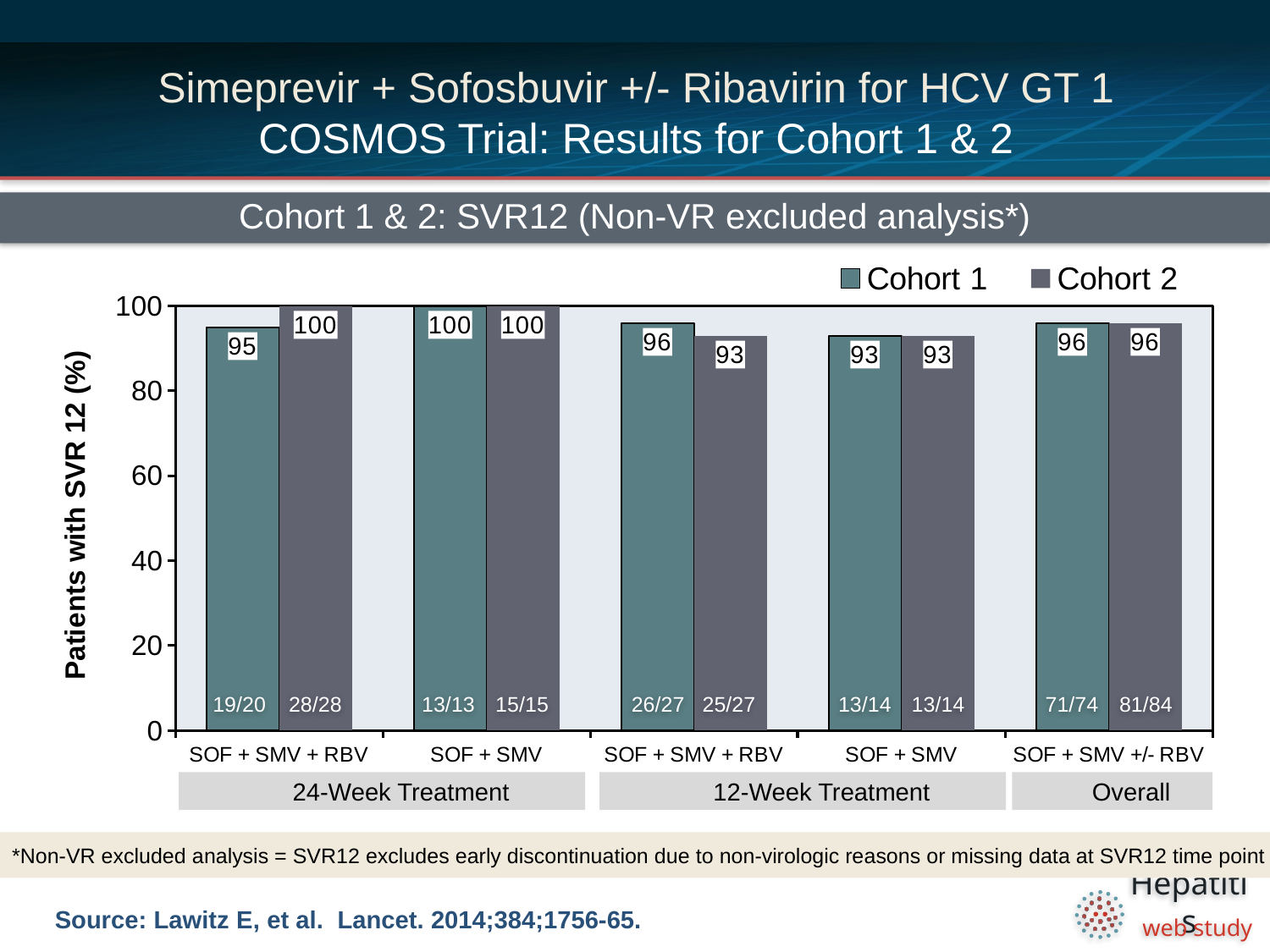
What is the label of the y axis? Patients with SVR 12 (%) Which treatment group has the lowest SVR12 rate for Cohort 1? 12-Week Treatment SOF + SMV How many treatment groups are shown on the x axis? 5 What kind of chart is shown on the slide? Bar chart How many series does the legend list? 2 What is the difference between the Cohort 2 and Cohort 1 SVR12 rates in the 24-Week Treatment SOF + SMV + RBV group? 5 What is the SVR12 rate for Cohort 1 in the 24-Week Treatment SOF + SMV + RBV group? 95 What is the difference between the Cohort 1 and Cohort 2 SVR12 rates in the 12-Week Treatment SOF + SMV + RBV group? 3 What is the SVR12 rate for Cohort 2 in the 24-Week Treatment SOF + SMV + RBV group? 100 What is the SVR12 rate for Cohort 1 in the Overall SOF + SMV +/- RBV group? 96 What is the SVR12 rate for Cohort 2 in the 12-Week Treatment SOF + SMV + RBV group? 93 In the 12-Week Treatment SOF + SMV + RBV group, which cohort has the higher SVR12 rate? Cohort 1